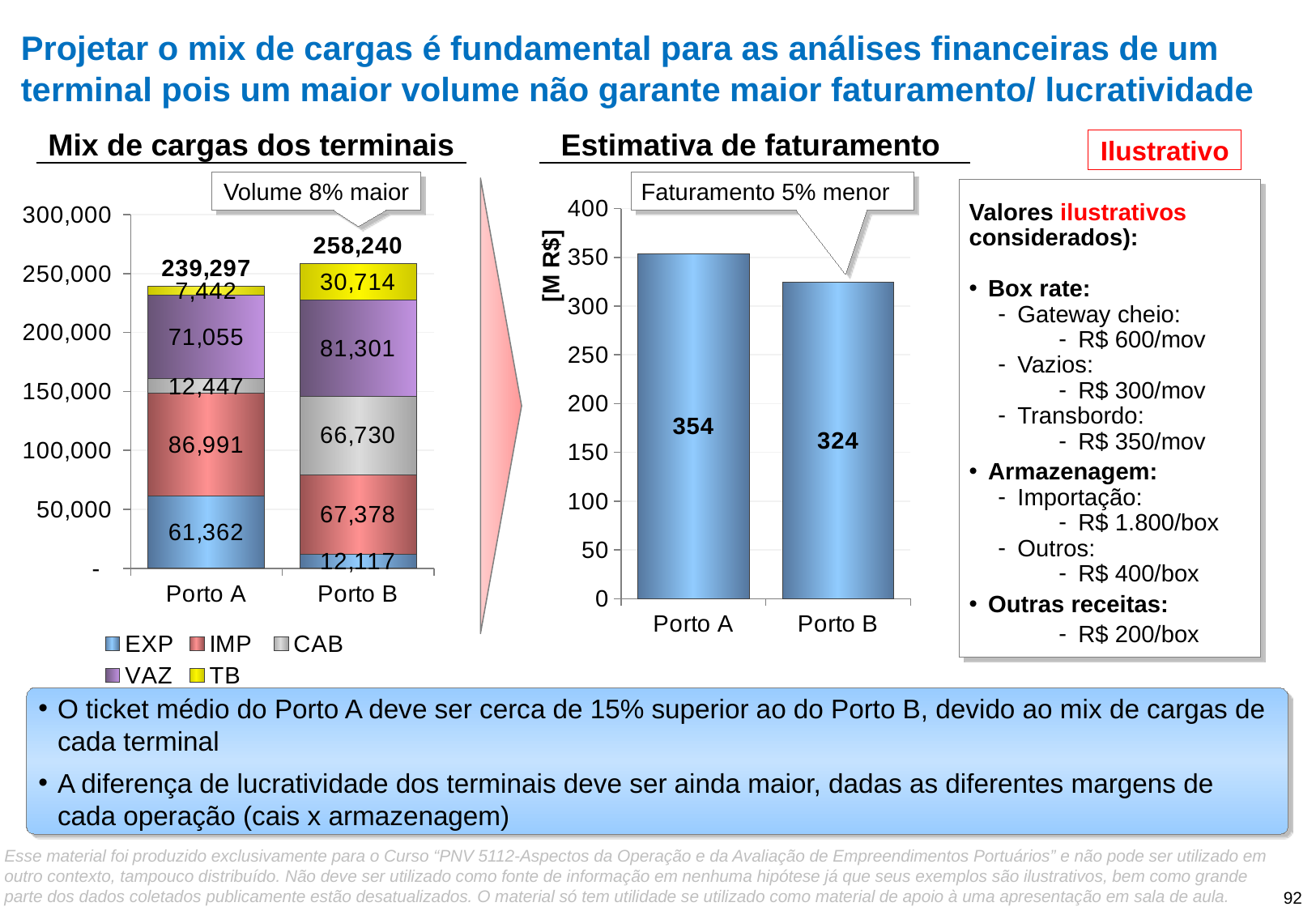
What is the y-axis unit label on the 'Estimativa de faturamento' chart? [M R$] In the 'Estimativa de faturamento' chart, which port has the highest value? Porto A In the 'Mix de cargas dos terminais' chart, what is the total of the stacked bar for Porto B? 258,240 In the 'Mix de cargas dos terminais' chart, what is the CAB value for Porto B? 66,730 In the 'Mix de cargas dos terminais' chart, what is the total of the stacked bar for Porto A? 239,297 In the 'Mix de cargas dos terminais' chart, which port has the larger VAZ value? Porto B In the 'Estimativa de faturamento' chart, what is the value for Porto B? 324 How many series does the legend of the 'Mix de cargas dos terminais' chart list? 5 In the 'Mix de cargas dos terminais' chart, what is the difference between the EXP values of Porto A and Porto B? 49,245 What kind of chart is 'Mix de cargas dos terminais'? Stacked bar chart In the 'Estimativa de faturamento' chart, what is the difference between Porto A and Porto B? 30 In the 'Mix de cargas dos terminais' chart, what is the IMP value for Porto A? 86,991